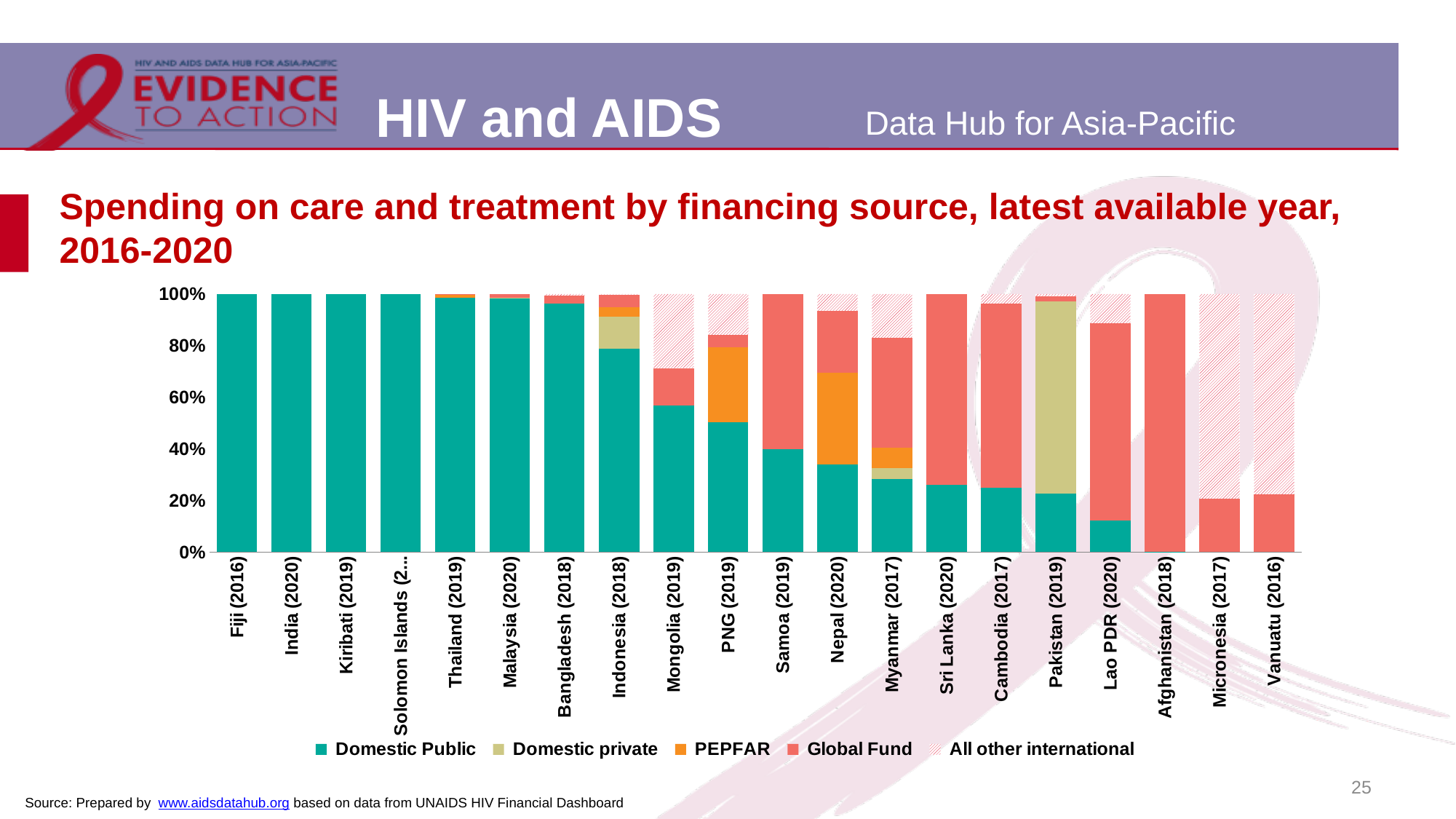
How many countries are shown on the x axis of the chart? 20 Which financing source is shown with a hatched pattern in the legend? All other international What kind of chart is shown on the slide? Stacked bar chart How many financing sources does the legend list? 5 Which country has the larger Domestic Public share, Mongolia (2019) or Nepal (2020)? Mongolia (2019) Which country has the largest Domestic private share? Pakistan (2019) Is the Domestic Public share for Indonesia (2018) greater or less than 60%? greater Is the Domestic private share for Pakistan (2019) greater or less than 60%? greater Is the Domestic Public share for Lao PDR (2020) greater or less than 20%? less What is the total of the stacked bar for Fiji (2016)? 100% Does the Domestic Public share generally rise or fall moving from left to right along the x axis? fall